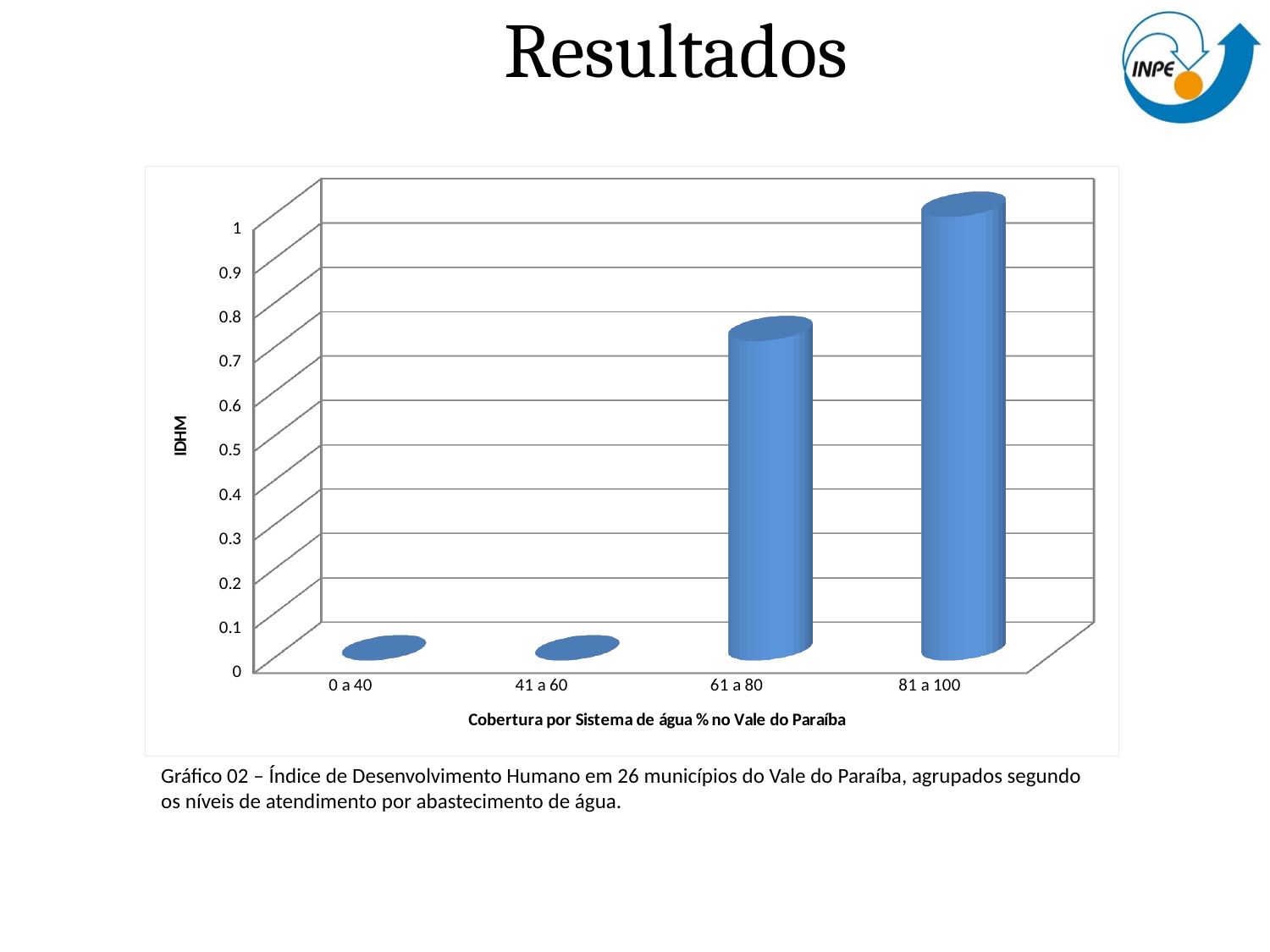
Which category has the highest IDHM value in the chart? 81 a 100 Which has a larger IDHM value, the category 61 a 80 or the category 81 a 100? 81 a 100 Is the IDHM value for the category 0 a 40 greater or less than 0.1? less Is the IDHM value for the category 61 a 80 greater or less than 0.9? less What is the label of the horizontal axis of the chart? Cobertura por Sistema de água % no Vale do Paraíba What is the label of the vertical axis of the chart? IDHM Which has a larger IDHM value, the category 41 a 60 or the category 61 a 80? 61 a 80 What kind of chart is shown on the slide? Bar chart Is the IDHM value for the category 81 a 100 greater or less than 0.8? greater Do the IDHM values generally rise or fall from left to right along the x axis? Rise How many categories are shown on the x axis of the chart? 4